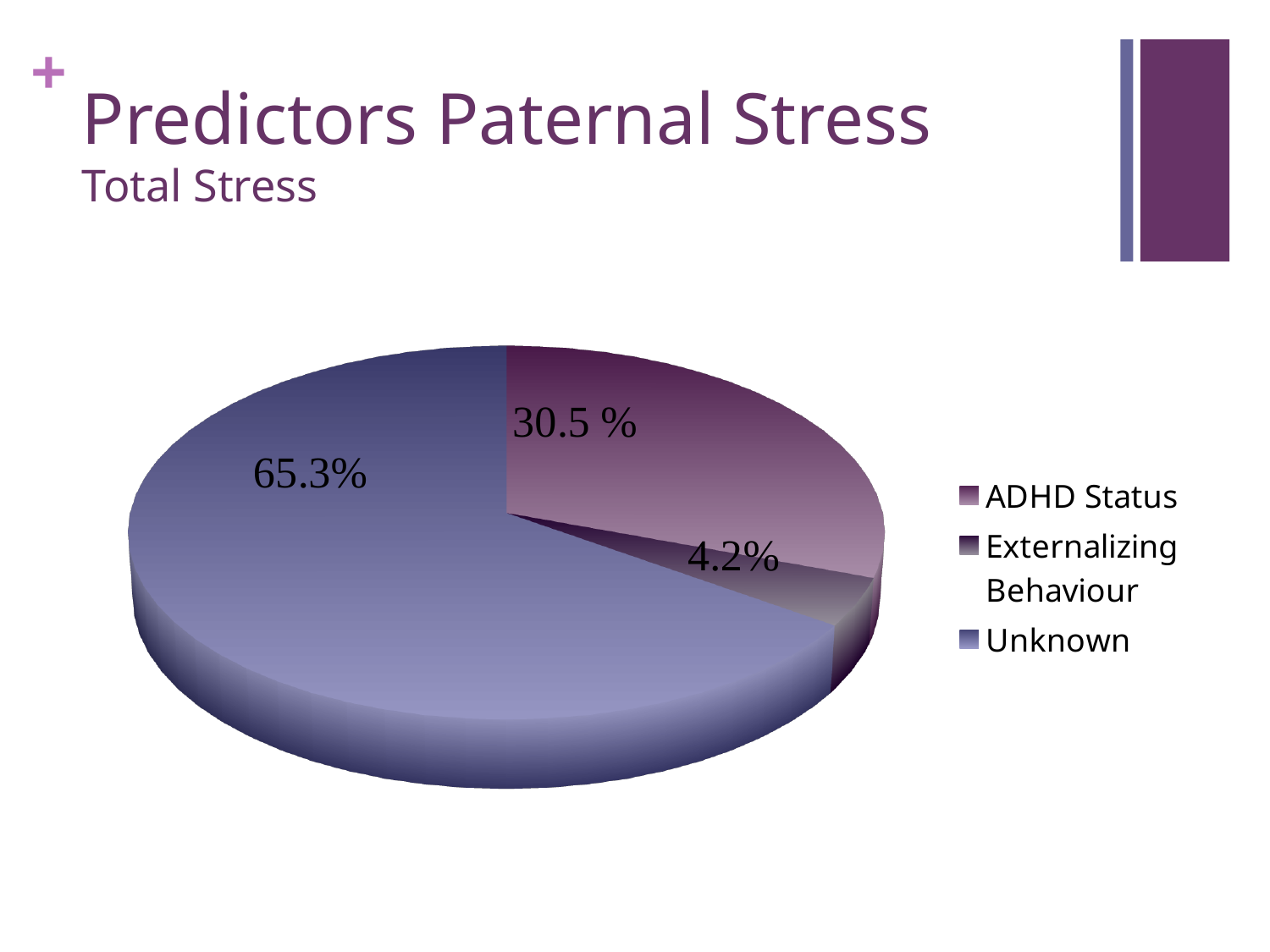
What percentage of the pie is labelled for Unknown? 65.3% How many entries does the legend list? 3 What percentage of the pie is labelled for Externalizing Behaviour? 4.2% Which category has the largest slice of the pie? Unknown What percentage of the pie is labelled for ADHD Status? 30.5 % Which slice is larger, ADHD Status or Externalizing Behaviour? ADHD Status How many slices does the pie chart have? 3 What is the difference between the Unknown slice and the ADHD Status slice? 34.8% What is the subtitle shown under the slide title 'Predictors Paternal Stress'? Total Stress What is the difference between the ADHD Status slice and the Externalizing Behaviour slice? 26.3% Which category has the smallest slice of the pie? Externalizing Behaviour What kind of chart is shown on the slide? Pie chart